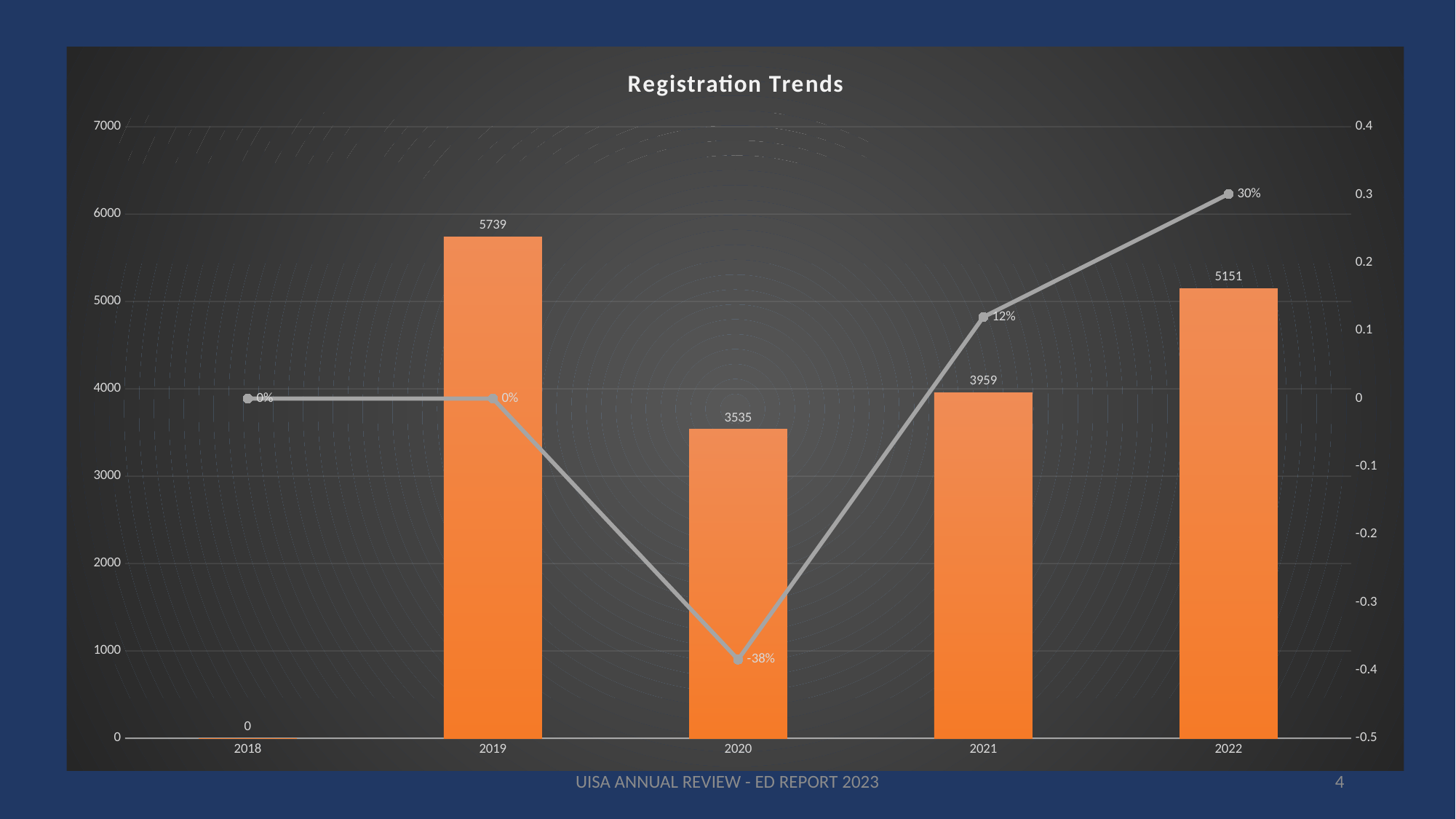
What is the registration value shown for 2019? 5739 What is the difference between the registration values for 2019 and 2020? 2204 What percentage change is shown on the line for 2022? 30% Which year has a larger registration value, 2021 or 2022? 2022 What is the registration value shown for 2020? 3535 Which year has the highest registration bar? 2019 Which year has the lowest registration bar? 2018 What percentage change is shown on the line for 2020? -38% What is the title of the chart? Registration Trends How many years are shown on the x axis? 5 Does the percentage line rise or fall from 2020 to 2022? rise What is the registration value shown for 2022? 5151